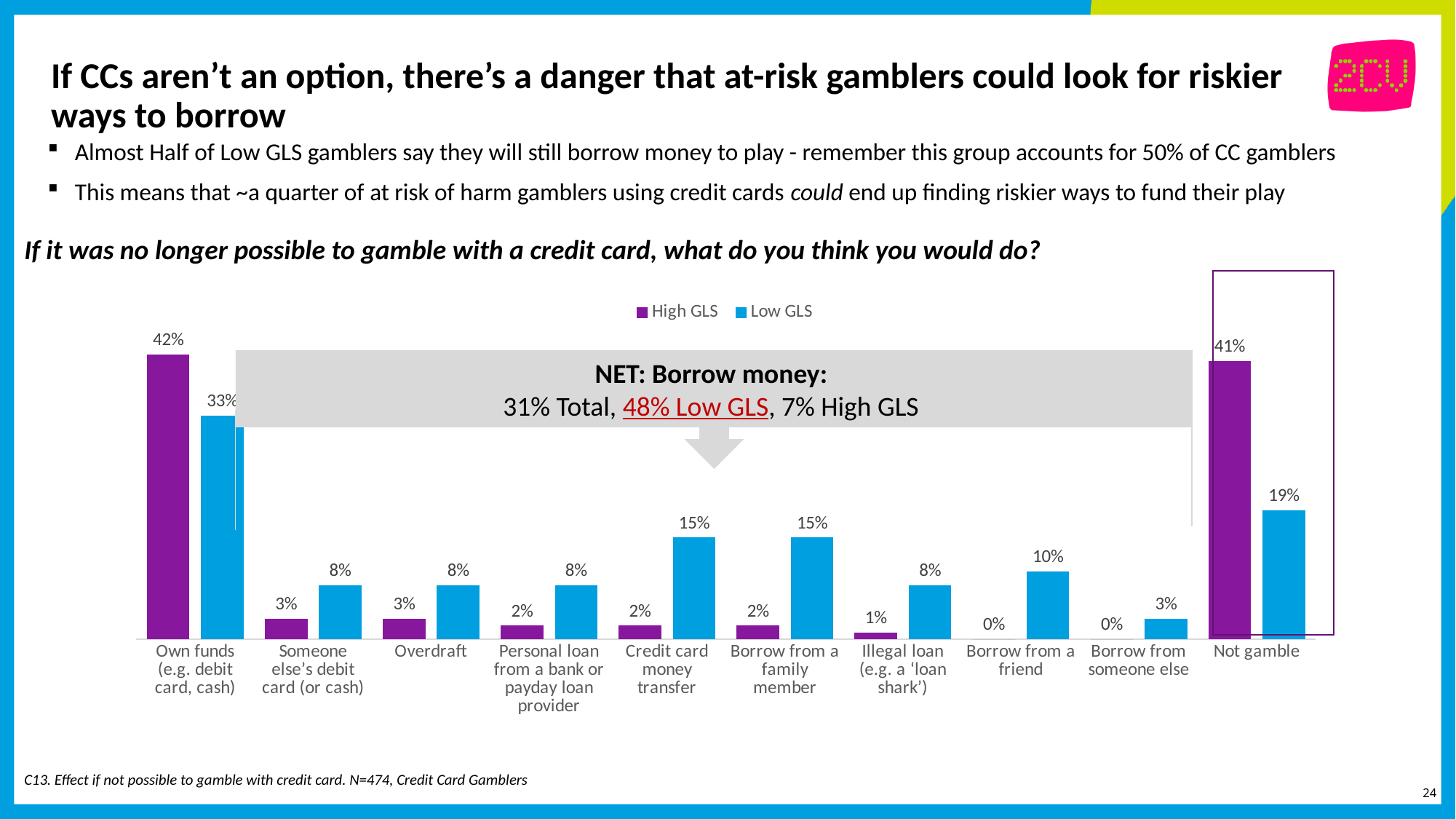
What type of chart is shown on the slide? Bar chart What is the Low GLS value for 'Not gamble'? 19% What is the difference between the High GLS and Low GLS values for 'Not gamble'? 22% Which category has the highest Low GLS value? Own funds (e.g. debit card, cash) What is the Low GLS value for 'Borrow from a friend'? 10% How many categories are shown on the x axis of the chart? 10 What is the High GLS value for 'Own funds (e.g. debit card, cash)'? 42% According to the grey box on the chart, what is the NET 'Borrow money' figure for Low GLS? 48% What is the difference between the Low GLS values for 'Own funds (e.g. debit card, cash)' and 'Not gamble'? 14% How many series does the legend list? 2 Which category has the lowest Low GLS value? Borrow from someone else For 'Credit card money transfer', which series has the larger value, High GLS or Low GLS? Low GLS